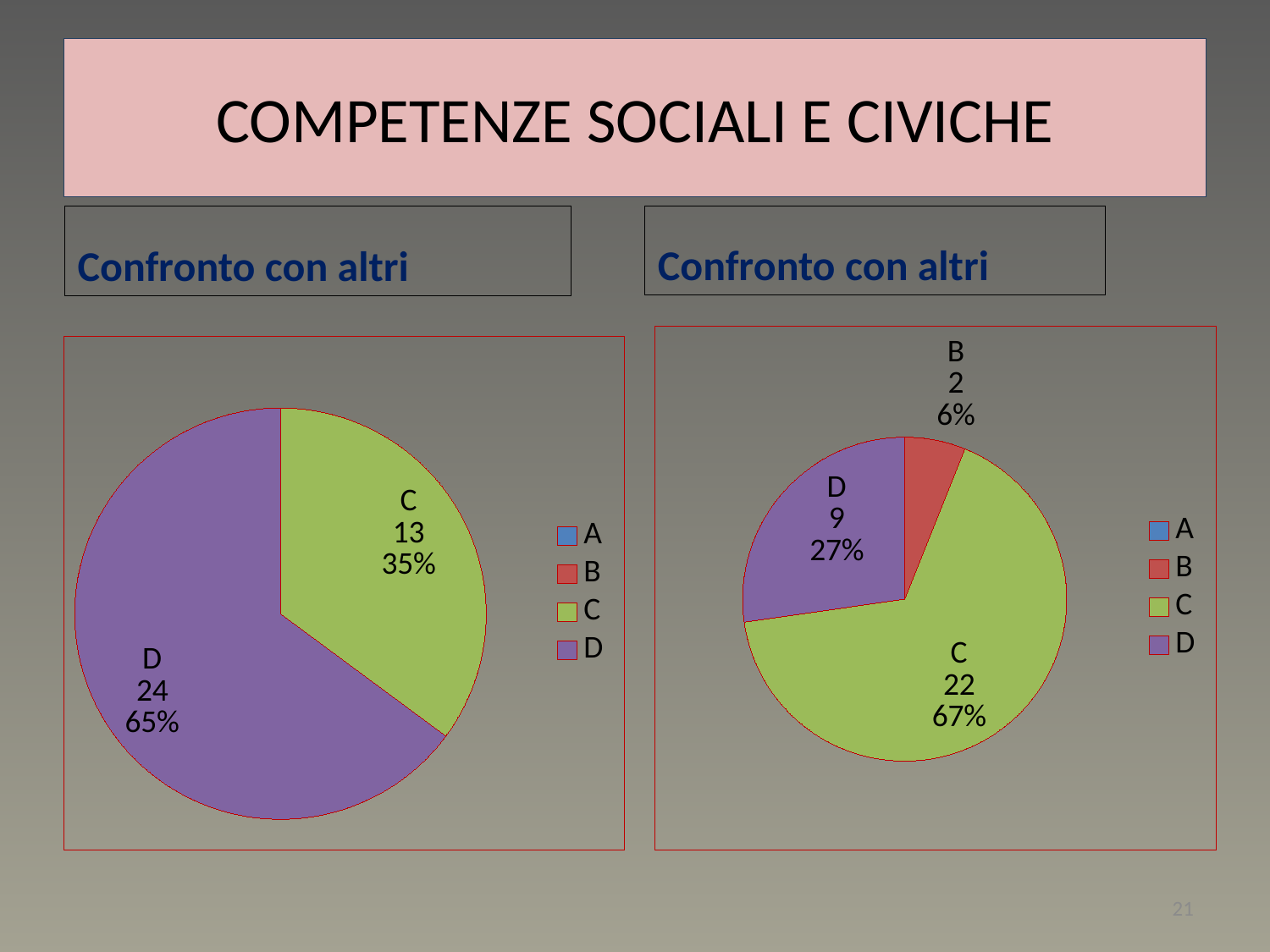
In the left pie chart, which category has the largest slice? D In the right pie chart, what percentage share does category B have? 6% In the left pie chart, what is the value for category D? 24 In the right pie chart, what is the value for category C? 22 In the right pie chart, which labelled category has the smallest slice? B In the right pie chart, what is the value for category D? 9 In the right pie chart, which category has the largest slice? C What type of chart is shown on the right side of the slide? Pie chart In the right pie chart, which is larger, the value for D or the value for B? D In the left pie chart, what is the difference between the values for D and C? 11 In the left pie chart, what percentage share does category C have? 35% How many entries does the legend of the left pie chart list? 4